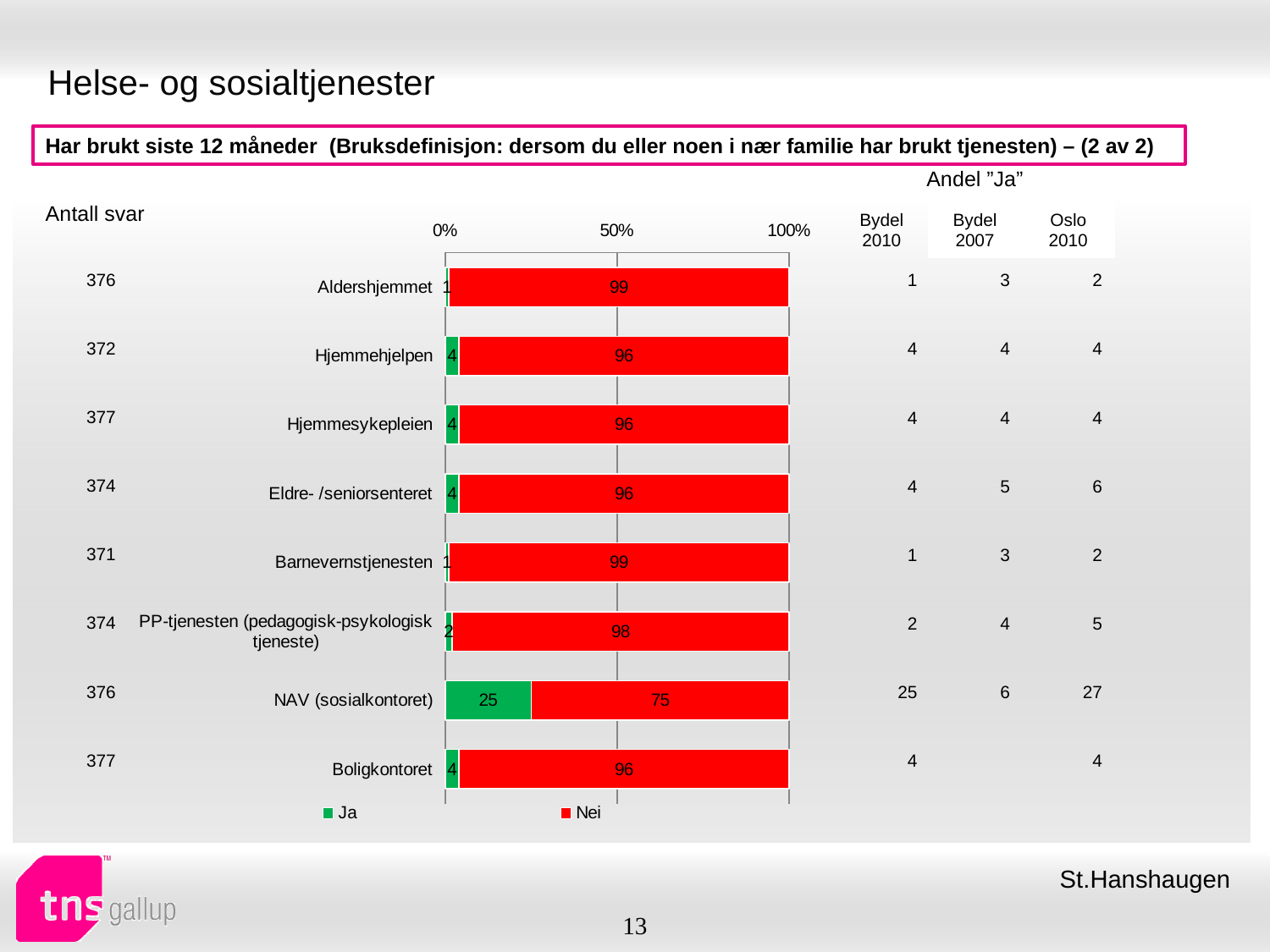
Which is larger, the 'Nei' value for Barnevernstjenesten or the 'Nei' value for Boligkontoret? Barnevernstjenesten Which series in the legend is shown in red? Nei What kind of chart is shown on the slide? stacked bar chart What is the 'Nei' value for Hjemmehjelpen? 96 What is the 'Ja' value for NAV (sosialkontoret)? 25 What is the difference between the 'Nei' values for Aldershjemmet and NAV (sosialkontoret)? 24 What is the 'Nei' value for Aldershjemmet? 99 What is the 'Nei' value for PP-tjenesten (pedagogisk-psykologisk tjeneste)? 98 Which category has the lowest 'Nei' value? NAV (sosialkontoret) Which category has the highest 'Ja' value? NAV (sosialkontoret) How many categories are plotted in the chart? 8 How many series does the chart legend list? 2